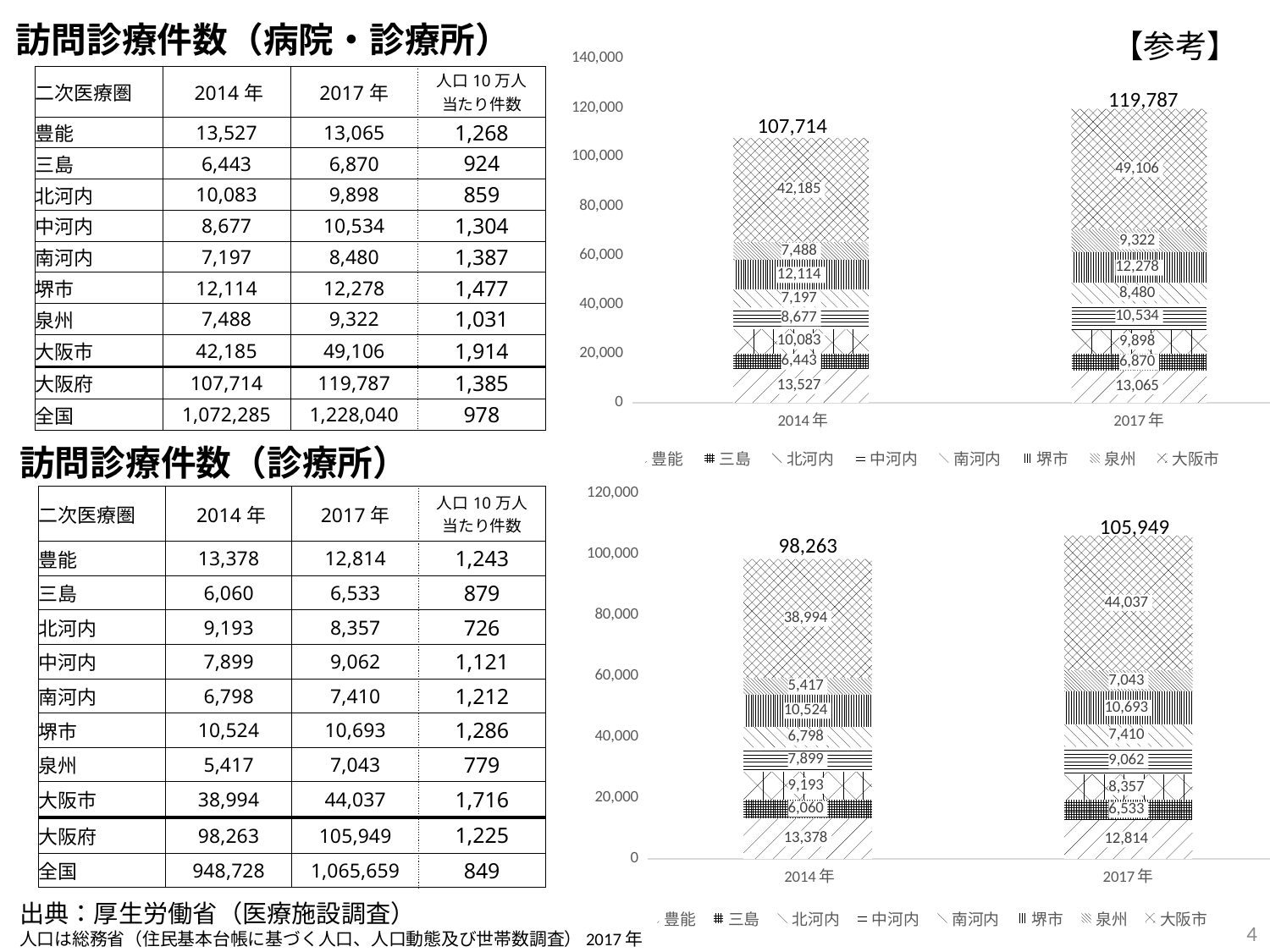
In the top chart, what is the value of the 泉州 segment in the 2014年 bar? 7,488 In the top chart, which segment is the largest in the 2017年 bar? 大阪市 How many series does the legend of the top chart list? 8 In the bottom chart, which segment is the smallest in the 2014年 bar? 泉州 What kind of chart is the bottom chart? stacked bar chart In the top chart, what is the value of the 大阪市 segment in the 2017年 bar? 49,106 In the top chart, what is the total of the stacked bar for 2014年? 107,714 In the bottom chart, what is the value of the 堺市 segment in the 2014年 bar? 10,524 How many bars (categories on the x axis) does the bottom chart show? 2 In the bottom chart, is the 豊能 segment larger in 2014年 or in 2017年? 2014年 In the bottom chart, what is the total of the stacked bar for 2017年? 105,949 In the top chart, what is the difference between the 2017年 total (119,787) and the 2014年 total (107,714)? 12,073